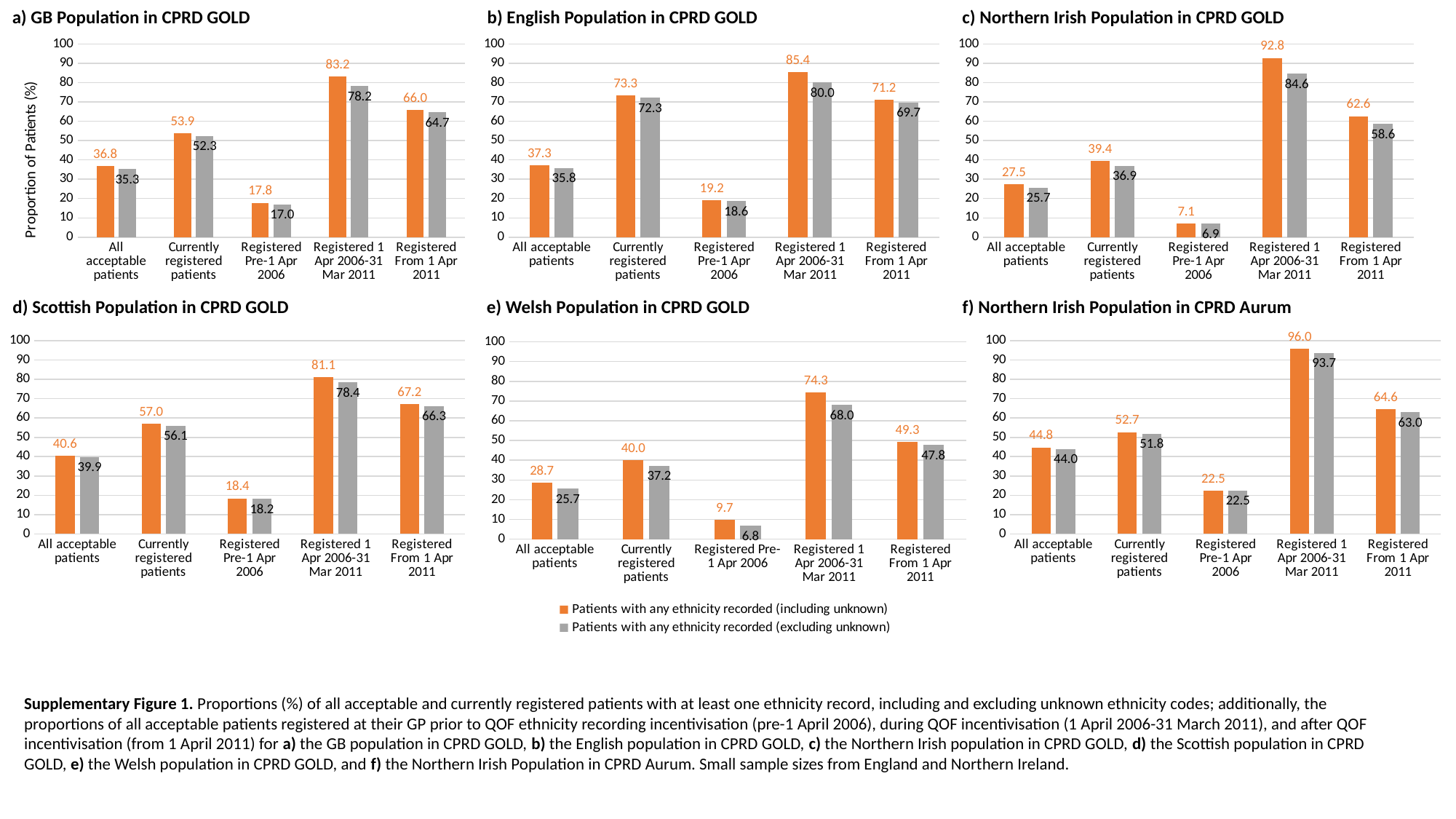
In the chart 'a) GB Population in CPRD GOLD', what is the value for 'Registered 1 Apr 2006-31 Mar 2011' for patients with any ethnicity recorded (including unknown)? 83.2 In the chart 'a) GB Population in CPRD GOLD', is the value for 'Registered From 1 Apr 2011' for patients with any ethnicity recorded (excluding unknown) greater or less than 60? greater What colour represents 'Patients with any ethnicity recorded (excluding unknown)' in the legend? Grey How many series does the legend list for the charts on the slide? 2 In the chart 'd) Scottish Population in CPRD GOLD', which is larger for 'Currently registered patients': the including-unknown value or the excluding-unknown value? Patients with any ethnicity recorded (including unknown) How many categories are shown on the x axis of the chart 'b) English Population in CPRD GOLD'? 5 In the chart 'e) Welsh Population in CPRD GOLD', what is the difference between the including-unknown and excluding-unknown values for 'Registered 1 Apr 2006-31 Mar 2011'? 6.3 In the chart 'b) English Population in CPRD GOLD', what is the value for 'All acceptable patients' for patients with any ethnicity recorded (excluding unknown)? 35.8 What kind of chart is 'e) Welsh Population in CPRD GOLD'? Bar chart In the chart 'f) Northern Irish Population in CPRD Aurum', which category has the highest value for patients with any ethnicity recorded (excluding unknown)? Registered 1 Apr 2006-31 Mar 2011 In the chart 'c) Northern Irish Population in CPRD GOLD', which category has the lowest value for patients with any ethnicity recorded (including unknown)? Registered Pre-1 Apr 2006 In the chart 'f) Northern Irish Population in CPRD Aurum', what is the value for 'Registered Pre-1 Apr 2006' for patients with any ethnicity recorded (including unknown)? 22.5